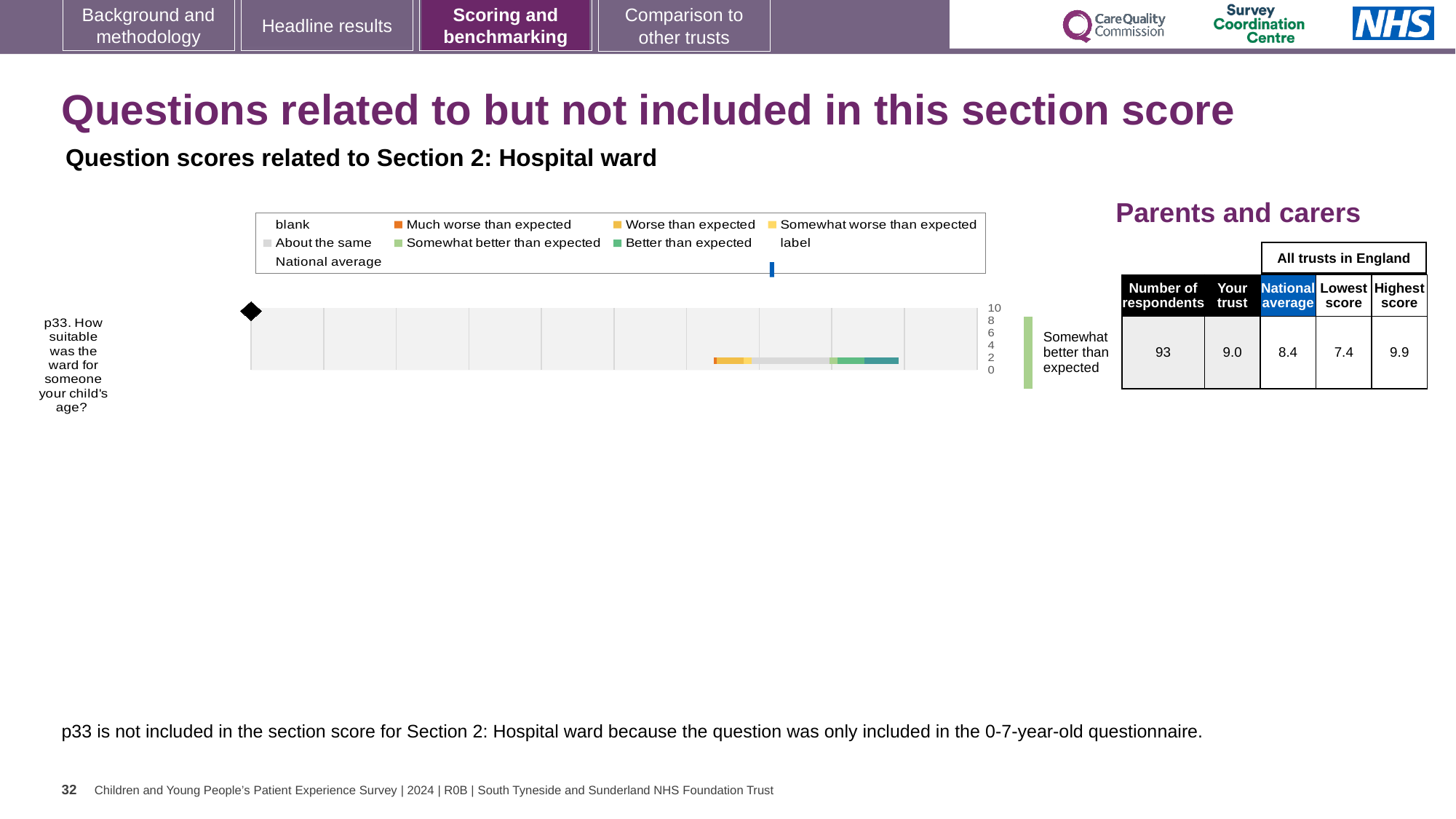
Is the 'Your trust' score for p33 higher or lower than the National average? higher In the table next to the chart, what is the Lowest score among all trusts in England for p33? 7.4 In the table next to the chart, what is the Highest score among all trusts in England for p33? 9.9 Which question is plotted in the chart? p33. How suitable was the ward for someone your child's age? What rating label is shown next to the chart for question p33? Somewhat better than expected What is the difference between the 'Your trust' score and the National average for p33? 0.6 In the table next to the chart, what is the National average score for p33? 8.4 How many questions (categories) are plotted in the chart? 1 In the table next to the chart, what is the 'Your trust' score for p33? 9.0 What is the difference between the Highest score and the Lowest score for p33? 2.5 What kind of chart is shown on the slide for question p33? bar chart In the table next to the chart, how many respondents answered p33? 93